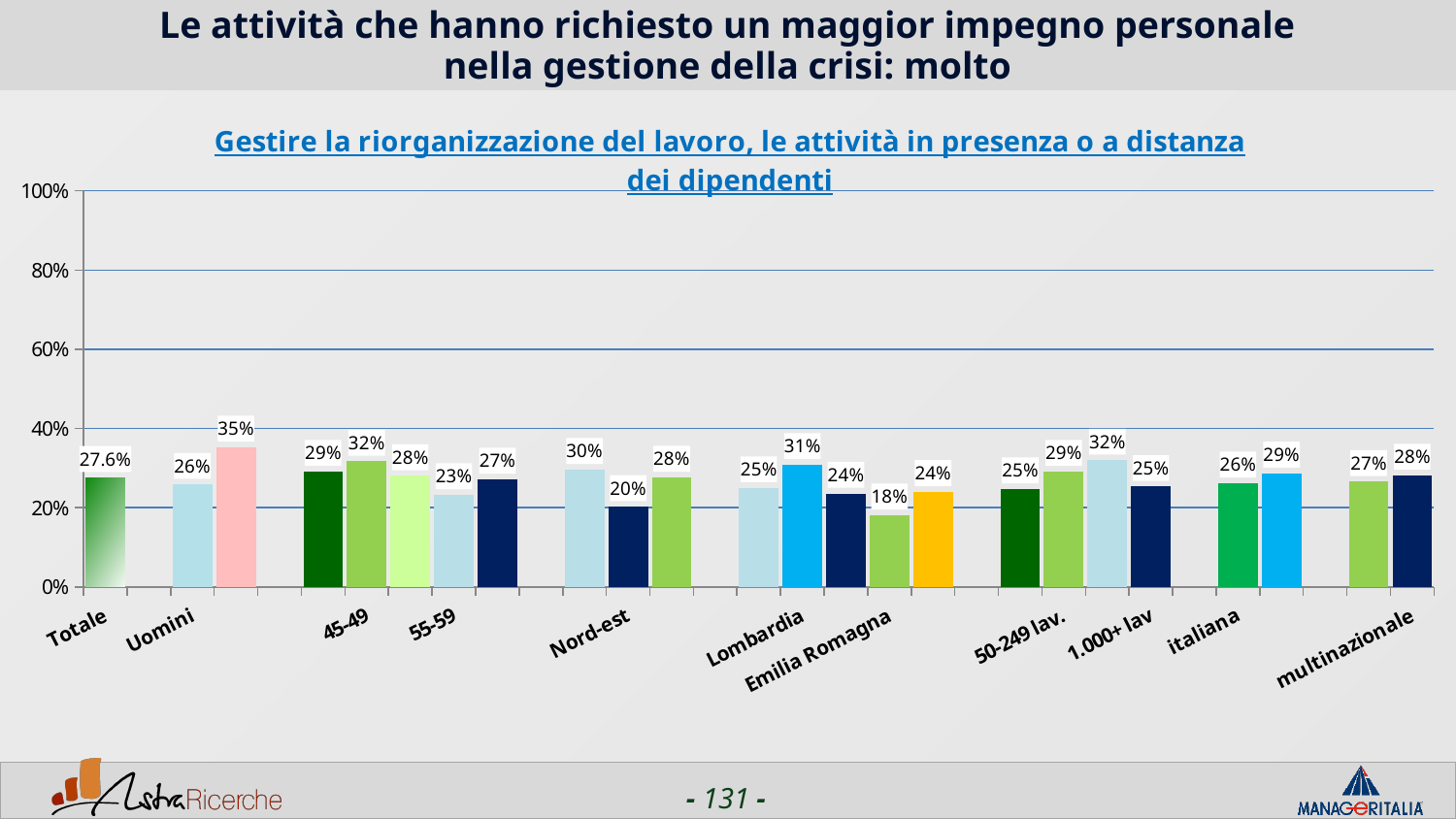
What is the value for multinazionale? 28% Is the value for Nord-est greater or less than 40%? less What is the highest value shown on the y axis? 100% What is the value for 50-249 lav.? 29% What kind of chart is shown on the slide? bar chart What is the value for Emilia Romagna? 18% What is the difference between the values for Lombardia and Emilia Romagna? 13% What is the title of the chart? Gestire la riorganizzazione del lavoro, le attività in presenza o a distanza dei dipendenti Which is larger, the value for 45-49 or the value for 55-59? 45-49 What is the value for Lombardia? 31% What is the value for Uomini? 26% What is the value for Totale? 27.6%